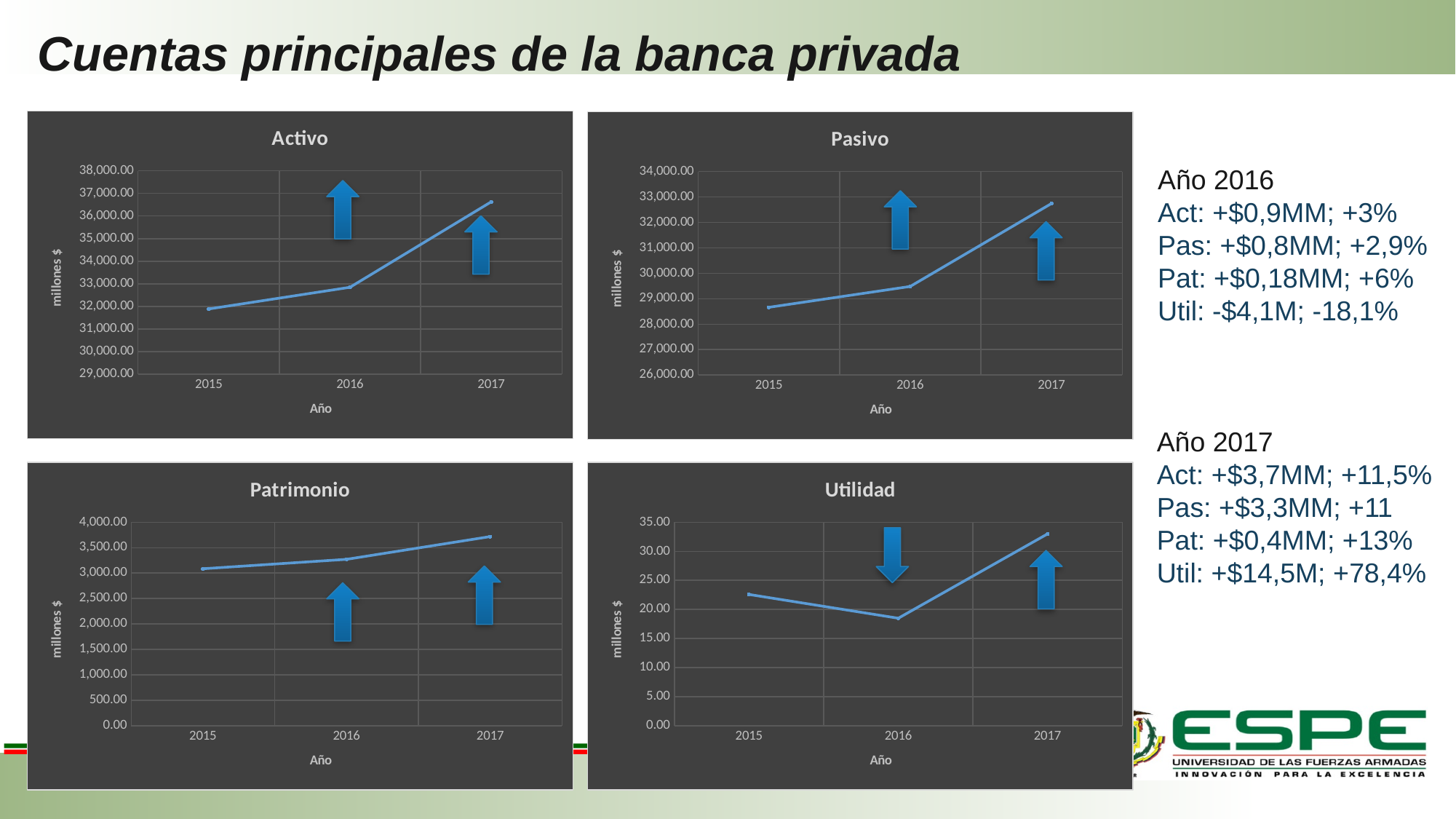
How many years are plotted on the Activo chart? 3 In the Utilidad chart, which year has the larger value, 2015 or 2016? 2015 In the Pasivo chart, do the values rise or fall from 2015 to 2017? rise In the Patrimonio chart, which year has the lowest value? 2015 In the Utilidad chart, is the value for 2017 greater or less than 30.00? greater What is the y-axis label on the Patrimonio chart? millones $ In the Pasivo chart, is the value for 2015 greater or less than 29,000.00? less In the Utilidad chart, which year has the lowest value? 2016 In the Activo chart, which year has the highest value? 2017 What kind of chart is the Activo chart? line chart In the Activo chart, is the value for 2017 greater or less than 35,000.00? greater